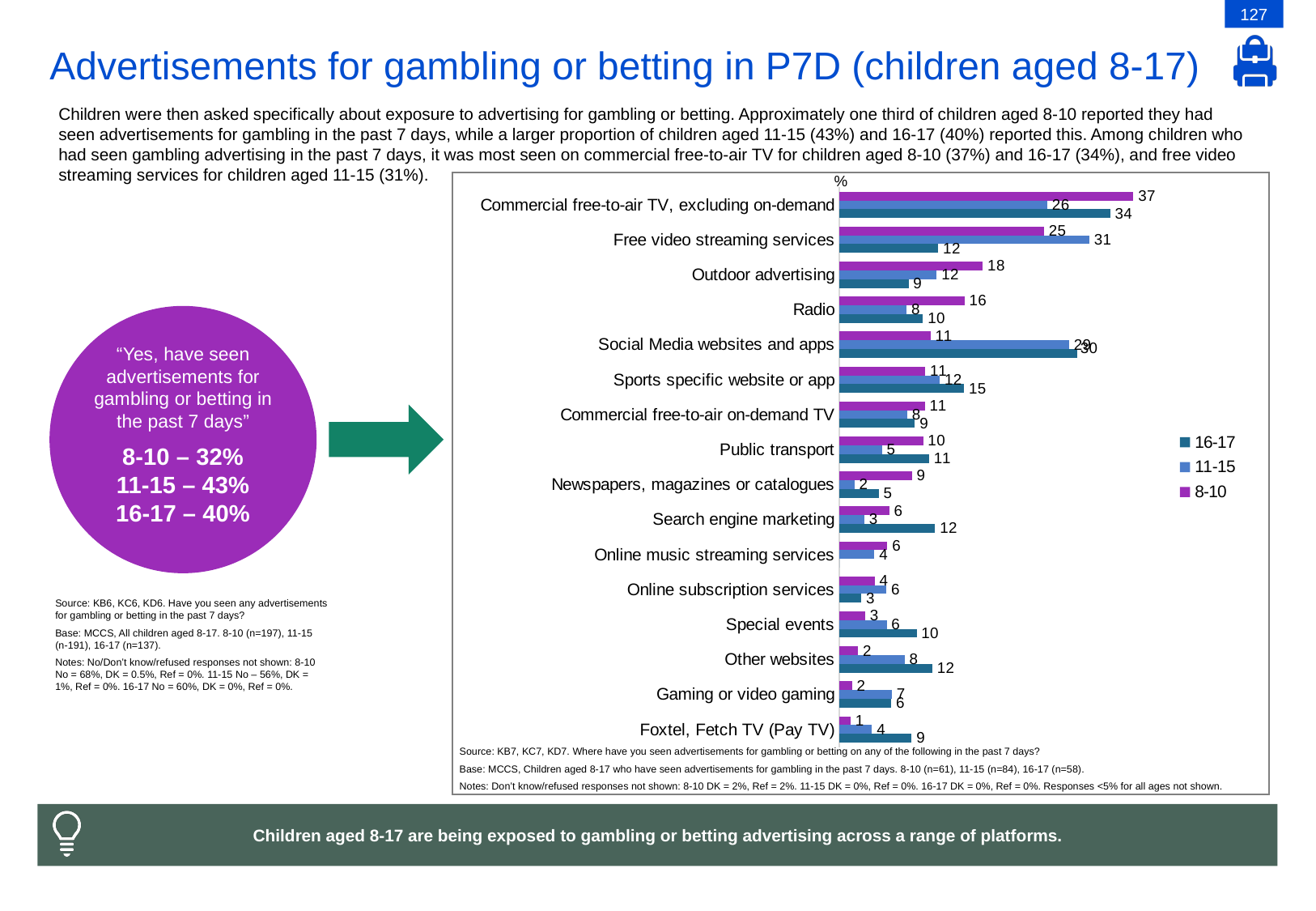
What is the value for children aged 11-15 for Free video streaming services? 31 Which legend entry is shown in purple? 8-10 How many platform categories are plotted in the chart? 16 Which platform has the highest value for children aged 8-10? Commercial free-to-air TV, excluding on-demand How many series does the chart legend list? 3 What is the value for children aged 16-17 for Search engine marketing? 12 What is the difference between the 8-10 and 16-17 values for Outdoor advertising? 9 What is the value for children aged 8-10 for Commercial free-to-air TV, excluding on-demand? 37 For Radio, which age group has the larger value: 8-10 or 11-15? 8-10 Which platform has the lowest value for children aged 8-10? Foxtel, Fetch TV (Pay TV) What is the difference between the 11-15 and 16-17 values for Free video streaming services? 19 What kind of chart is shown on the slide? Bar chart